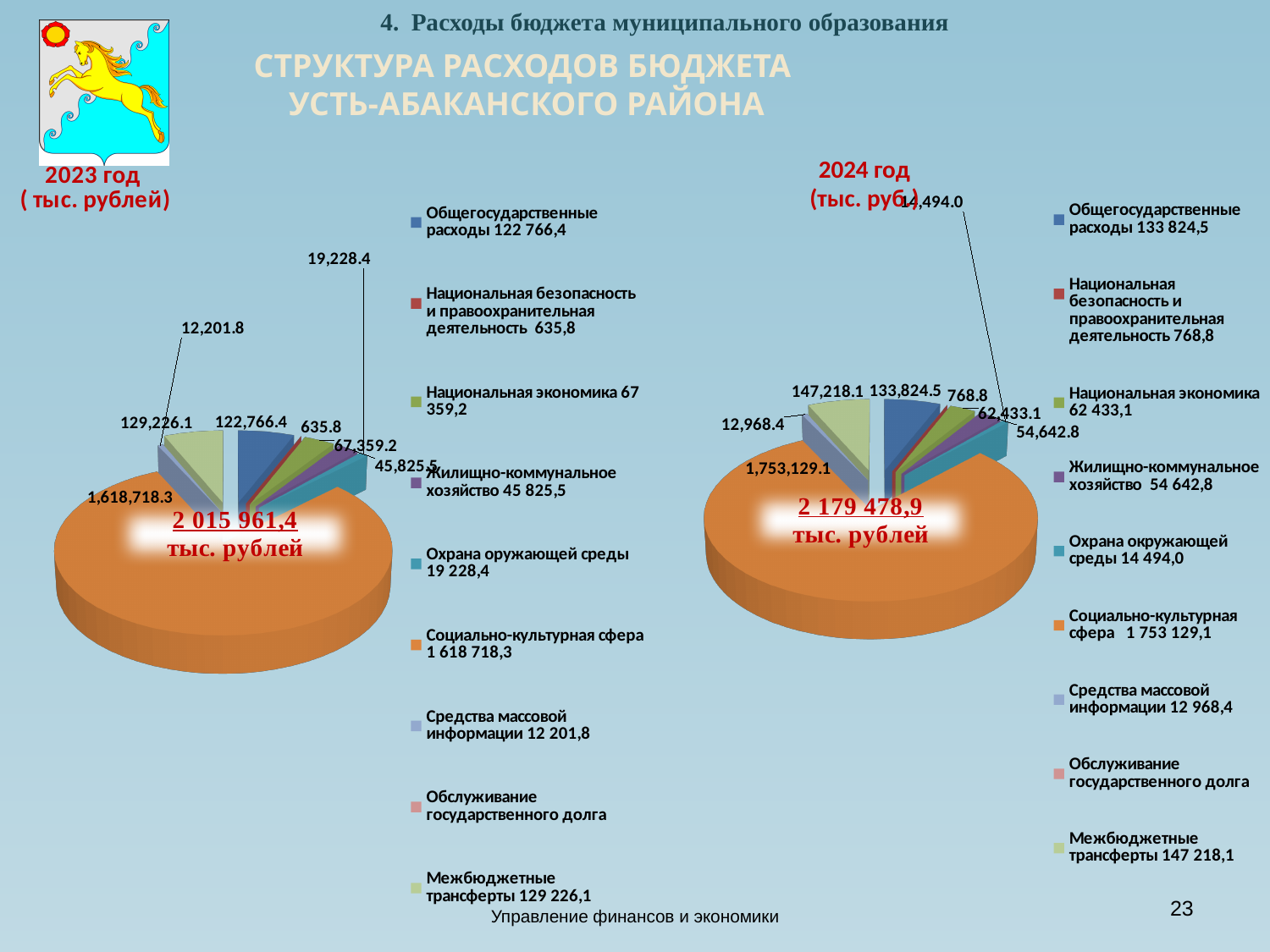
In the 2023 chart, which is larger: Межбюджетные трансферты or Общегосударственные расходы? Межбюджетные трансферты What total is printed on the 2024 pie chart? 2 179 478,9 тыс. рублей In the 2023 chart, what is the value for Социально-культурная сфера? 1 618 718,3 In the 2024 chart, what is the value for Охрана окружающей среды? 14 494,0 In the 2024 chart, what is the value for Общегосударственные расходы? 133 824,5 In the 2023 chart, which category has the smallest labelled value? Национальная безопасность и правоохранительная деятельность What type of chart is used to show the 2023 budget expenditure structure? Pie chart In the 2023 chart, what is the value for Межбюджетные трансферты? 129 226,1 In the 2024 chart, which is larger: Национальная экономика or Жилищно-коммунальное хозяйство? Национальная экономика How many categories does the legend of the 2024 chart list? 9 What is the difference between Общегосударственные расходы in the 2024 chart and in the 2023 chart? 11 058,1 In the 2024 chart, which category has the largest value? Социально-культурная сфера